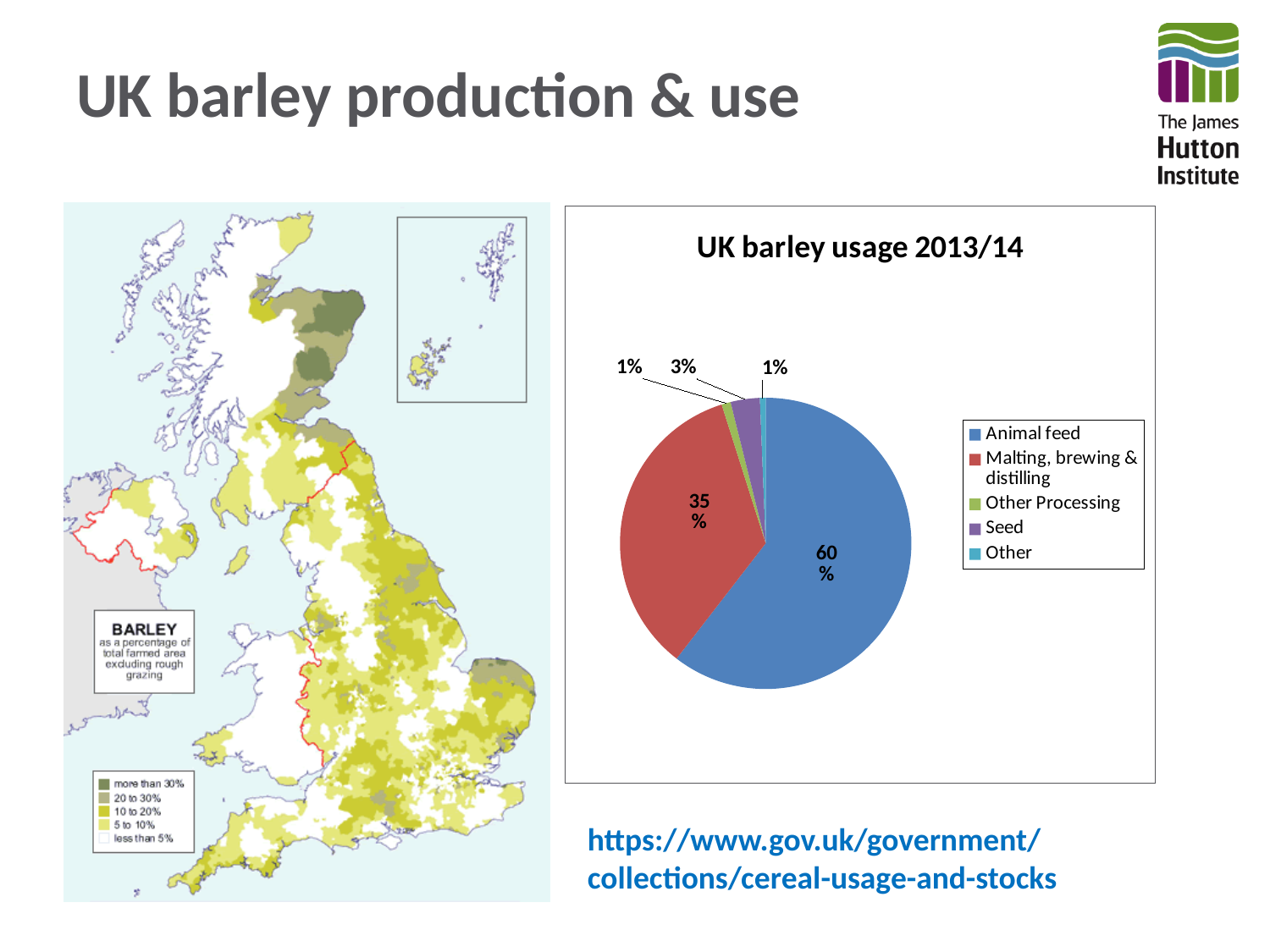
In the 'UK barley usage 2013/14' pie chart, what share is Seed? 3% In the 'UK barley usage 2013/14' pie chart, what share is Animal feed? 60% In the 'UK barley usage 2013/14' pie chart, which category has the largest share? Animal feed In the 'UK barley usage 2013/14' pie chart, what colour is the Animal feed slice? Blue In the 'UK barley usage 2013/14' pie chart, what share is Malting, brewing & distilling? 35% What is the title of the pie chart on the slide? UK barley usage 2013/14 In the 'UK barley usage 2013/14' pie chart, what is the difference in percentage points between Animal feed and Malting, brewing & distilling? 25 How many categories does the legend of the 'UK barley usage 2013/14' pie chart list? 5 What kind of chart is 'UK barley usage 2013/14'? Pie chart In the 'UK barley usage 2013/14' pie chart, what share is Other Processing? 1% In the 'UK barley usage 2013/14' pie chart, what is the combined share of Seed and Other? 4% In the 'UK barley usage 2013/14' pie chart, which is larger, Seed or Other Processing? Seed